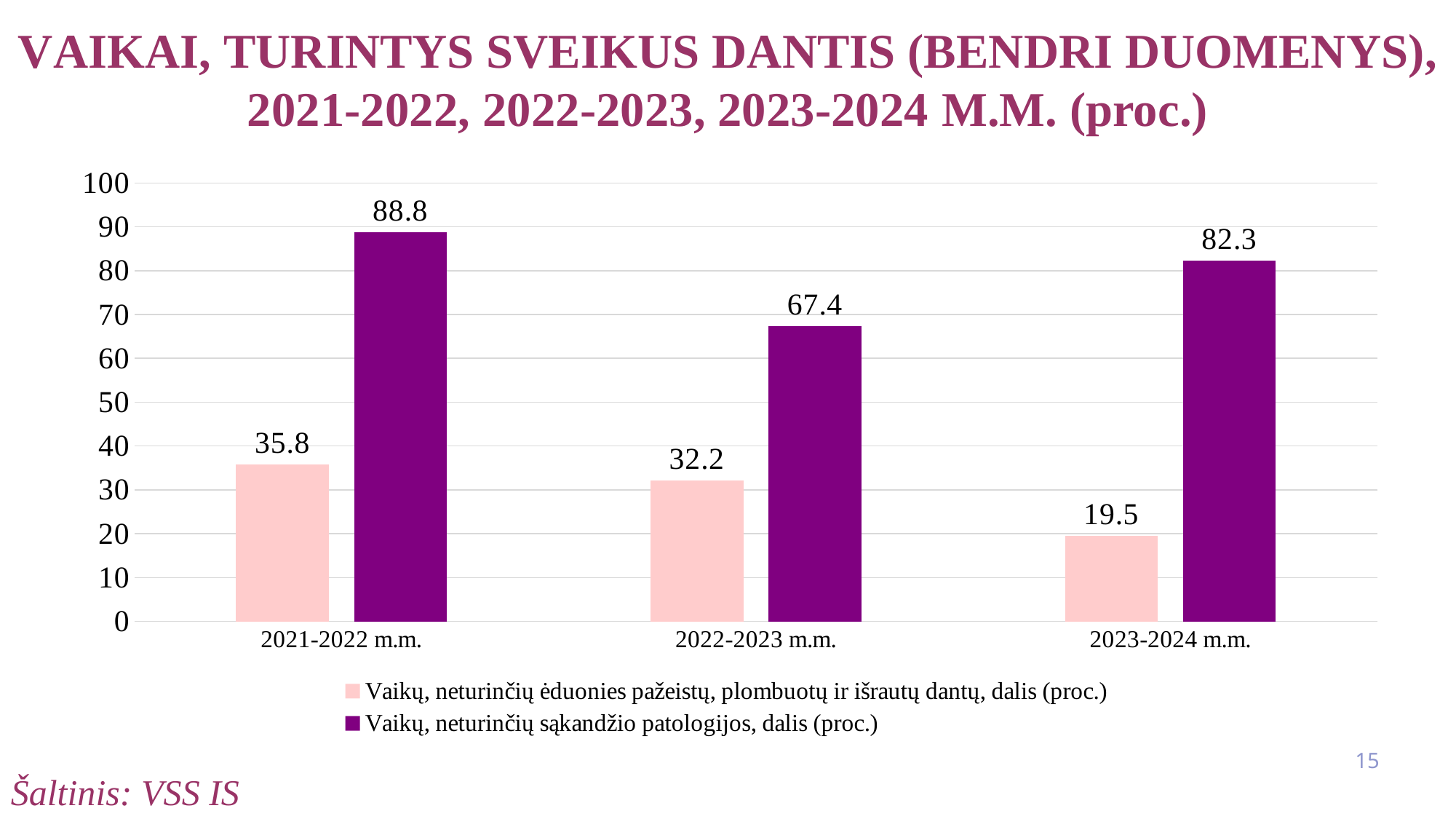
What source is cited at the bottom of the slide? VSS IS What is the difference between the two series' values in 2023-2024 m.m.? 62.8 Which is larger: the value for 'Vaikų, neturinčių sąkandžio patologijos, dalis (proc.)' in 2022-2023 m.m. or in 2023-2024 m.m.? 2023-2024 m.m. In which school year is the value for 'Vaikų, neturinčių ėduonies pažeistų, plombuotų ir išrautų dantų, dalis (proc.)' lowest? 2023-2024 m.m. Does the value for 'Vaikų, neturinčių ėduonies pažeistų, plombuotų ir išrautų dantų, dalis (proc.)' rise or fall from 2021-2022 m.m. to 2023-2024 m.m.? Fall What is the value for 'Vaikų, neturinčių sąkandžio patologijos, dalis (proc.)' in 2022-2023 m.m.? 67.4 What is the value for 'Vaikų, neturinčių ėduonies pažeistų, plombuotų ir išrautų dantų, dalis (proc.)' in 2023-2024 m.m.? 19.5 What is the value for 'Vaikų, neturinčių ėduonies pažeistų, plombuotų ir išrautų dantų, dalis (proc.)' in 2021-2022 m.m.? 35.8 What kind of chart is shown on the slide? Bar chart How many series does the legend list? 2 How many school years are shown on the x axis? 3 In which school year is the value for 'Vaikų, neturinčių sąkandžio patologijos, dalis (proc.)' highest? 2021-2022 m.m.